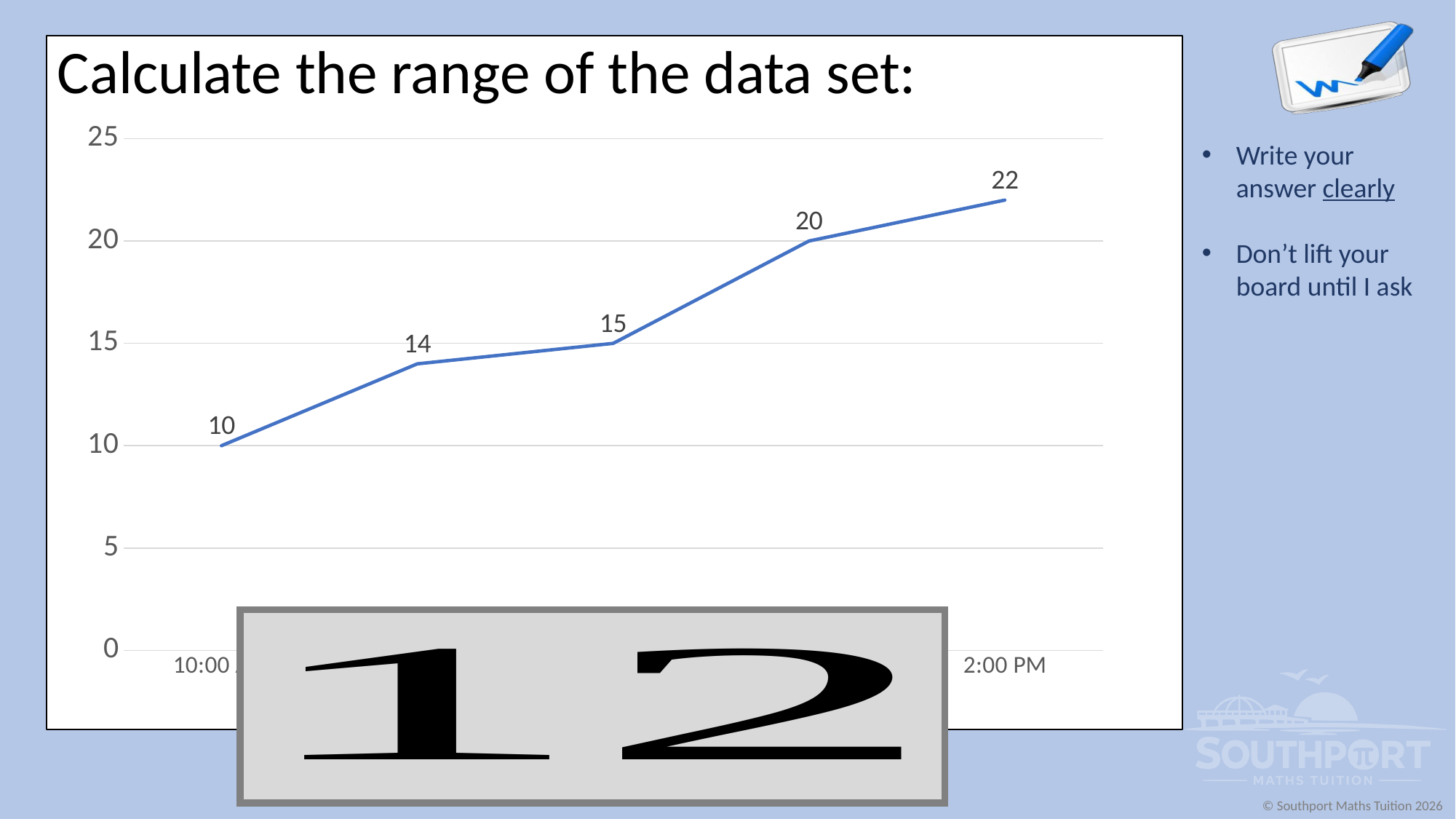
Which is larger, the value at 2:00 PM or the value of the first data point? 2:00 PM What is the lowest value plotted on the line? 10 What is the difference between the highest and lowest values on the line? 12 What is the value plotted at 2:00 PM? 22 How many data points are plotted on the line? 5 What is the difference between the second data point (14) and the fourth data point (20)? 6 What is the value of the first data point on the line? 10 What is the highest value plotted on the line? 22 What is the value of the third data point on the line? 15 What kind of chart is shown on the slide? line chart Do the values rise or fall from left to right along the x axis? rise What is the title shown above the chart? Calculate the range of the data set: